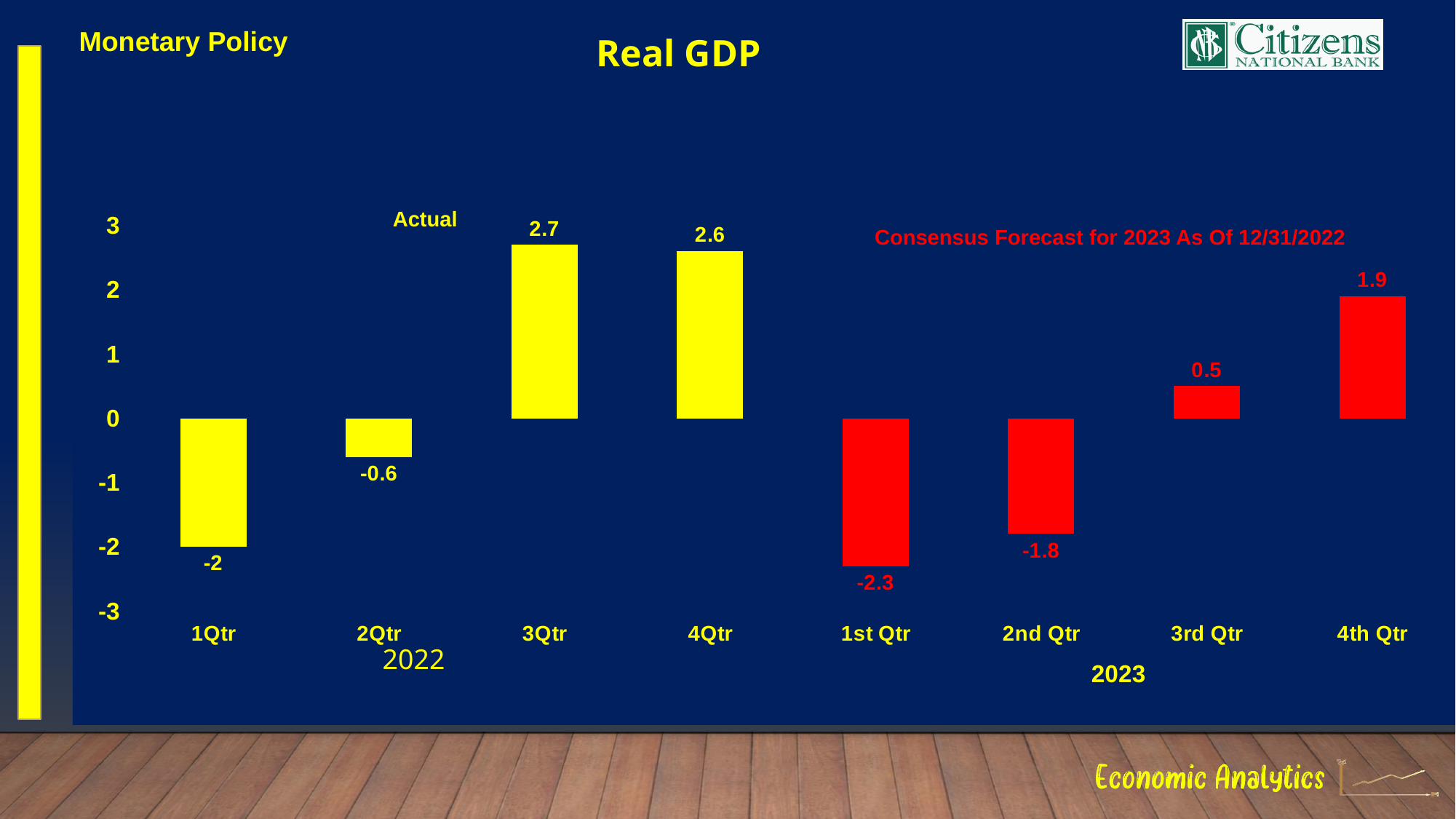
Which is larger, the value for 2Qtr 2022 or the value for 2nd Qtr 2023? 2Qtr 2022 How many quarters are plotted on the chart? 8 What is the title of the chart? Real GDP What is the consensus forecast value for 1st Qtr 2023? -2.3 What is the difference between the 3Qtr 2022 value and the 4Qtr 2022 value? 0.1 What is the consensus forecast value for 4th Qtr 2023? 1.9 What is the Real GDP value for 3Qtr 2022? 2.7 Which quarter has the lowest Real GDP value on the chart? 1st Qtr 2023 Which quarter has the highest Real GDP value on the chart? 3Qtr 2022 What is the Real GDP value for 1Qtr 2022? -2 Do the forecast values rise or fall from 1st Qtr 2023 to 4th Qtr 2023? Rise What kind of chart is shown on the slide? Bar chart